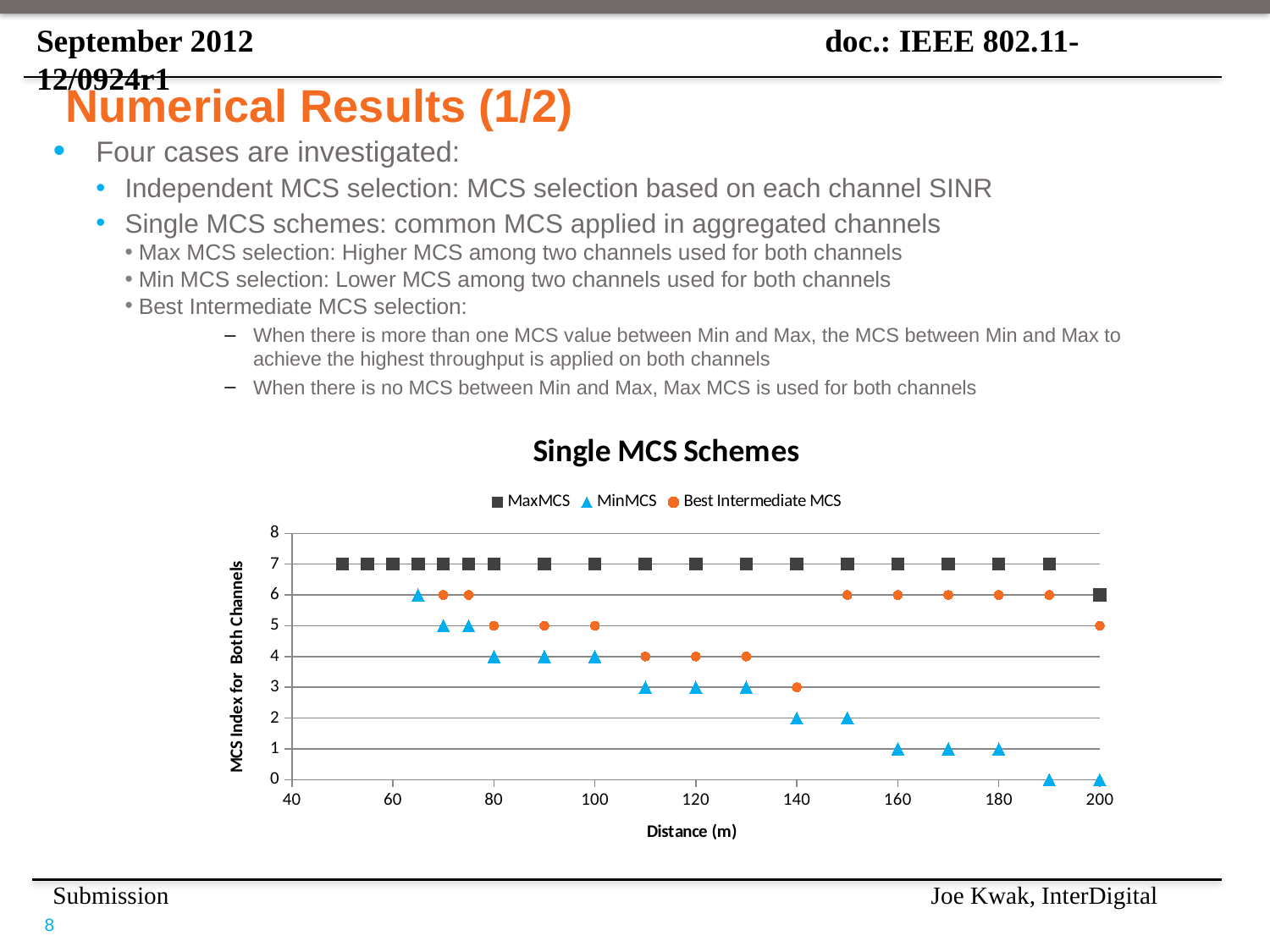
What kind of chart is shown on the slide? Scatter chart What is the MinMCS value at a distance of 190 m? 0 What is the label of the x axis? Distance (m) At a distance of 120 m, which is larger: the MaxMCS value or the MinMCS value? MaxMCS What is the difference between the MaxMCS value and the MinMCS value at a distance of 200 m? 6 What is the Best Intermediate MCS value at a distance of 160 m? 6 What is the MaxMCS value at a distance of 200 m? 6 How many series does the chart legend list? 3 What is the title of the chart? Single MCS Schemes What is the Best Intermediate MCS value at a distance of 140 m? 3 Does the MinMCS value rise or fall as distance increases? Fall What is the MinMCS value at a distance of 100 m? 4